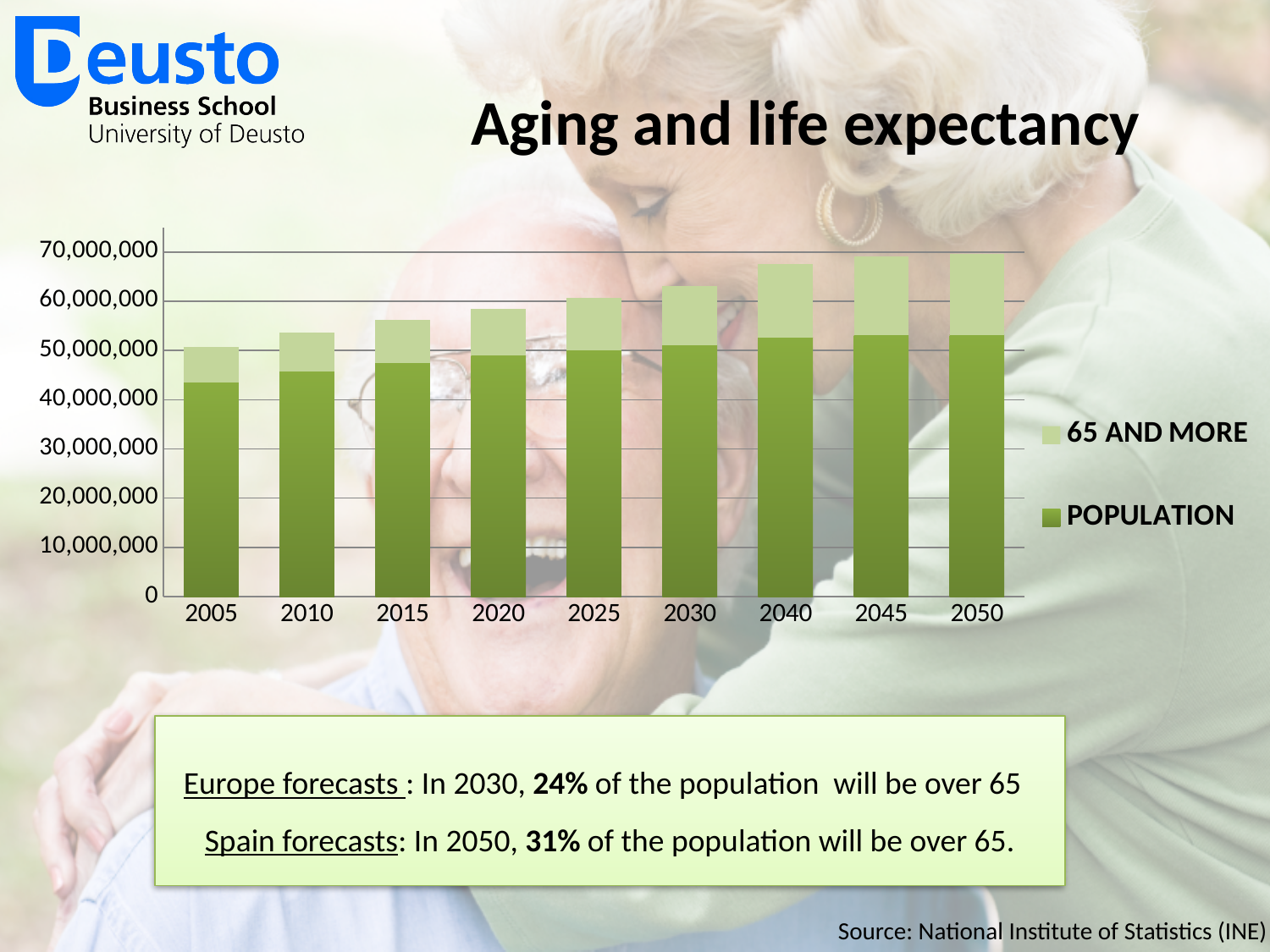
Which is larger, the POPULATION value for 2005 or for 2050? 2050 What are the two series named in the chart legend? 65 AND MORE and POPULATION Do the total bar heights rise or fall from 2005 to 2050? rise How many series does the chart legend list? 2 Which year has the lowest total bar in the chart? 2005 Is the total bar for 2020 greater or less than 60,000,000? less Is the POPULATION value for 2005 greater or less than 50,000,000? less What kind of chart is shown on the slide? stacked bar chart Is the total bar for 2040 greater or less than 60,000,000? greater How many years are shown on the x axis of the chart? 9 What is the highest value shown on the chart's y axis? 70,000,000